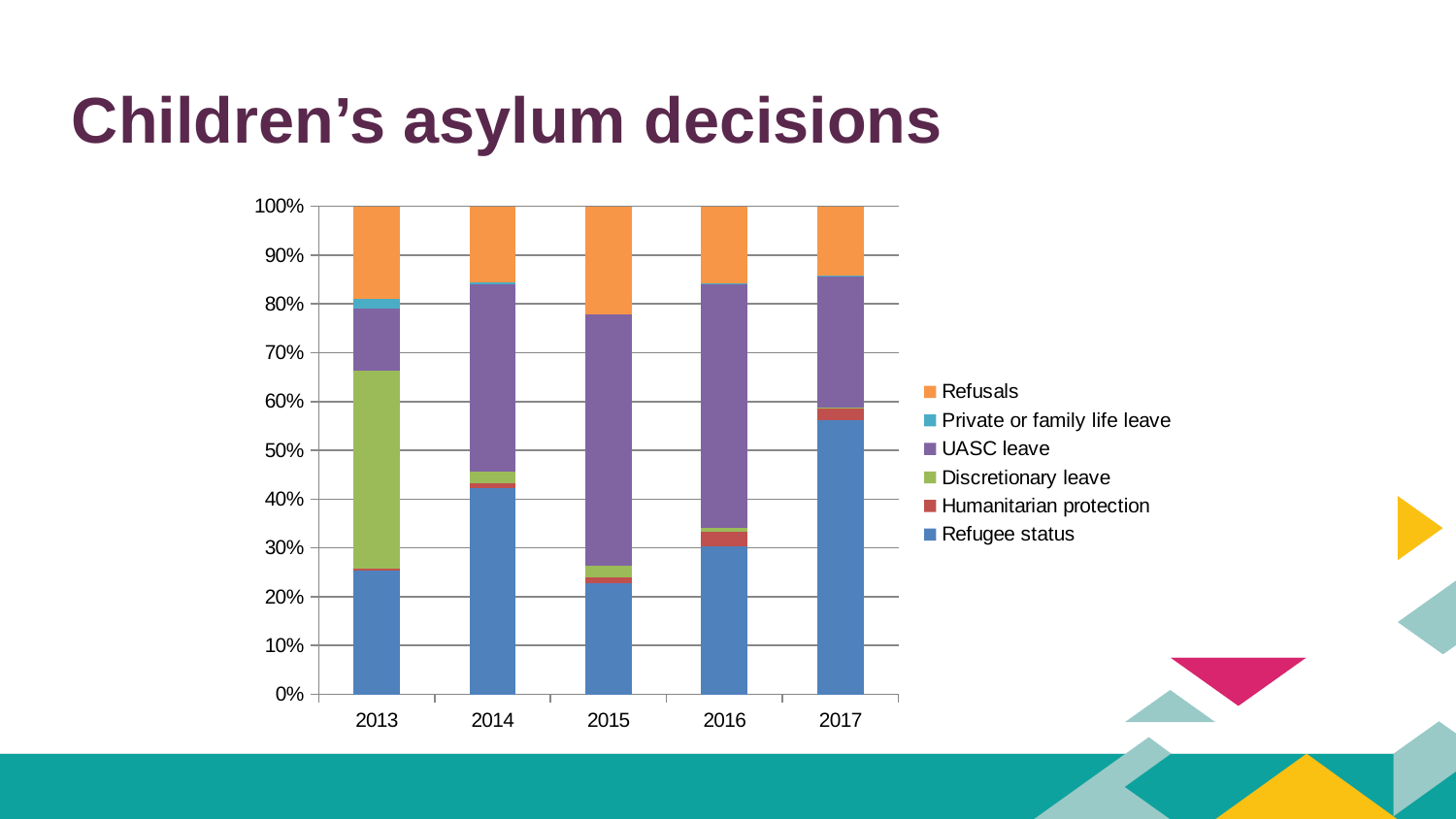
Which year has the largest share of Discretionary leave? 2013 How many series does the chart's legend list? 6 Is the Refugee status share for 2013 greater or less than 30%? less Which year has the larger Refugee status share, 2014 or 2016? 2014 Which year has the largest share of Refugee status? 2017 Which series is listed first (at the top) in the chart's legend? Refusals Is the Refugee status share for 2017 greater or less than 50%? greater What kind of chart is shown on the slide? Stacked bar chart Does the Refugee status share rise or fall from 2015 to 2017? rise What is the title of the slide containing the chart? Children's asylum decisions Is the Refugee status share for 2014 greater or less than 40%? greater How many years are shown on the x axis of the chart? 5